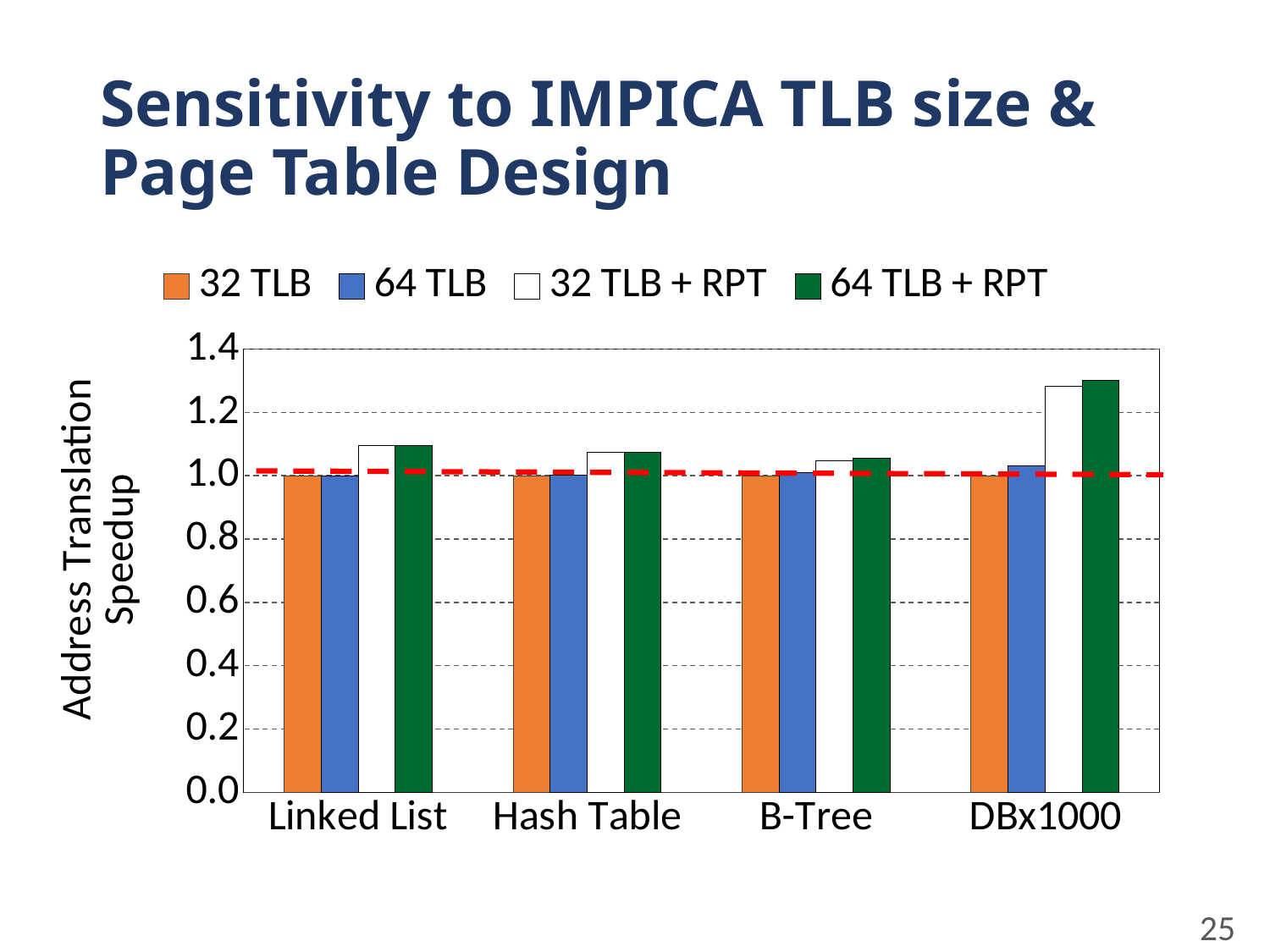
Which is larger for the 64 TLB + RPT series: Linked List or DBx1000? DBx1000 Which is larger for DBx1000: the 32 TLB value or the 64 TLB + RPT value? 64 TLB + RPT Which category has the highest value for the 64 TLB + RPT series? DBx1000 Which category has the highest value for the 32 TLB + RPT series? DBx1000 How many categories are shown on the x axis? 4 How many series does the legend list? 4 What is the label of the y axis? Address Translation Speedup What kind of chart is shown on the slide? bar chart Is the value for 32 TLB + RPT in Linked List greater or less than 1.2? less Is the value for 32 TLB in B-Tree greater or less than 1.2? less Is the value for 64 TLB + RPT in DBx1000 greater or less than 1.2? greater What is the name of the last series listed in the legend? 64 TLB + RPT